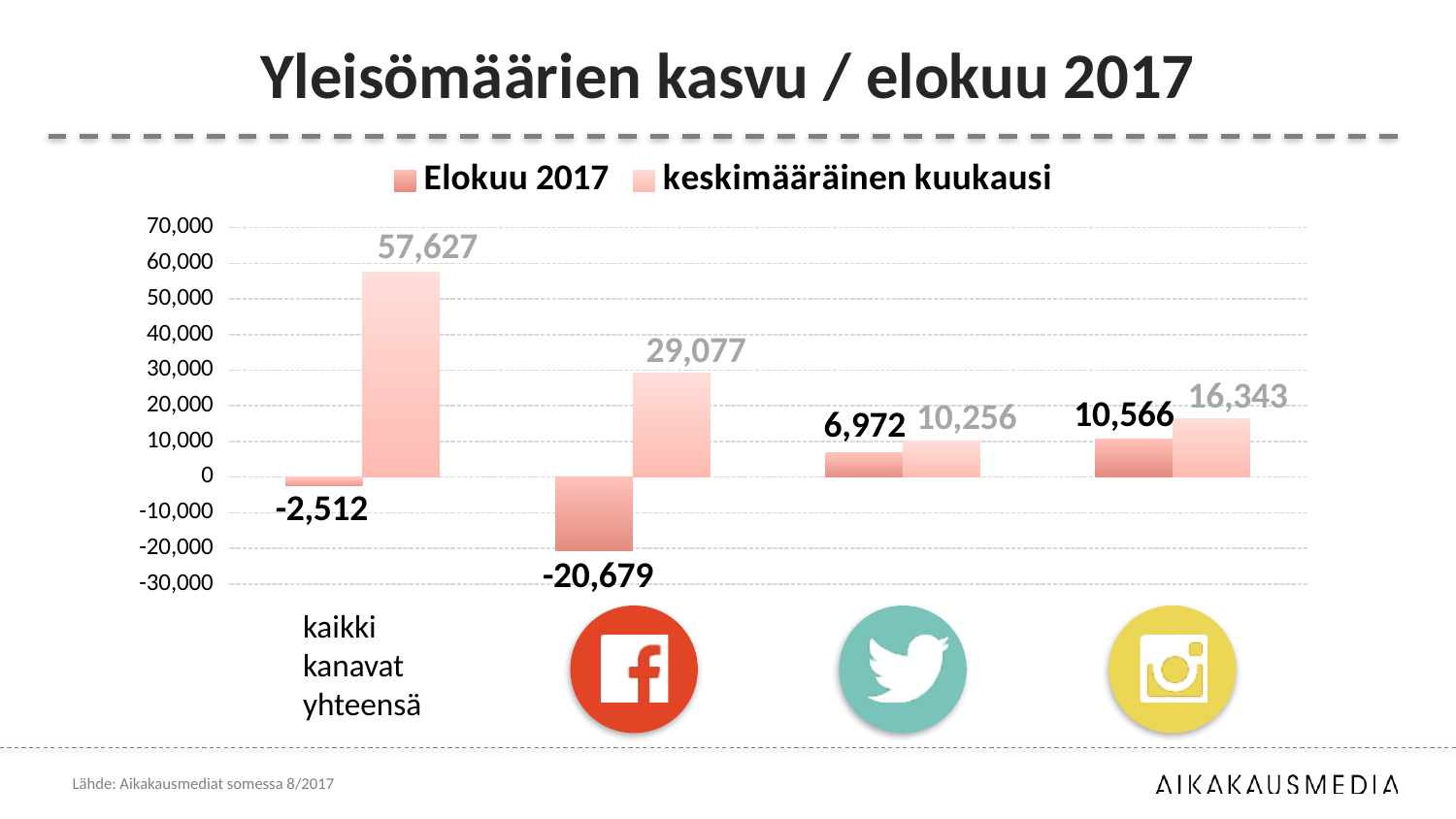
What is the keskimääräinen kuukausi value for kaikki kanavat yhteensä? 57,627 What is the title of the chart slide? Yleisömäärien kasvu / elokuu 2017 Which category has the lowest Elokuu 2017 value? Facebook How many series does the legend list? 2 What kind of chart is shown on the slide? bar chart What is the Elokuu 2017 value for the Facebook category? -20,679 What is the difference between the keskimääräinen kuukausi and Elokuu 2017 values for the Instagram category? 5,777 Which is larger for the Twitter category: the Elokuu 2017 value or the keskimääräinen kuukausi value? keskimääräinen kuukausi What is the keskimääräinen kuukausi value for the Twitter category? 10,256 What is the Elokuu 2017 value for kaikki kanavat yhteensä? -2,512 What is the Elokuu 2017 value for the Instagram category? 10,566 Which category has the highest keskimääräinen kuukausi value? kaikki kanavat yhteensä